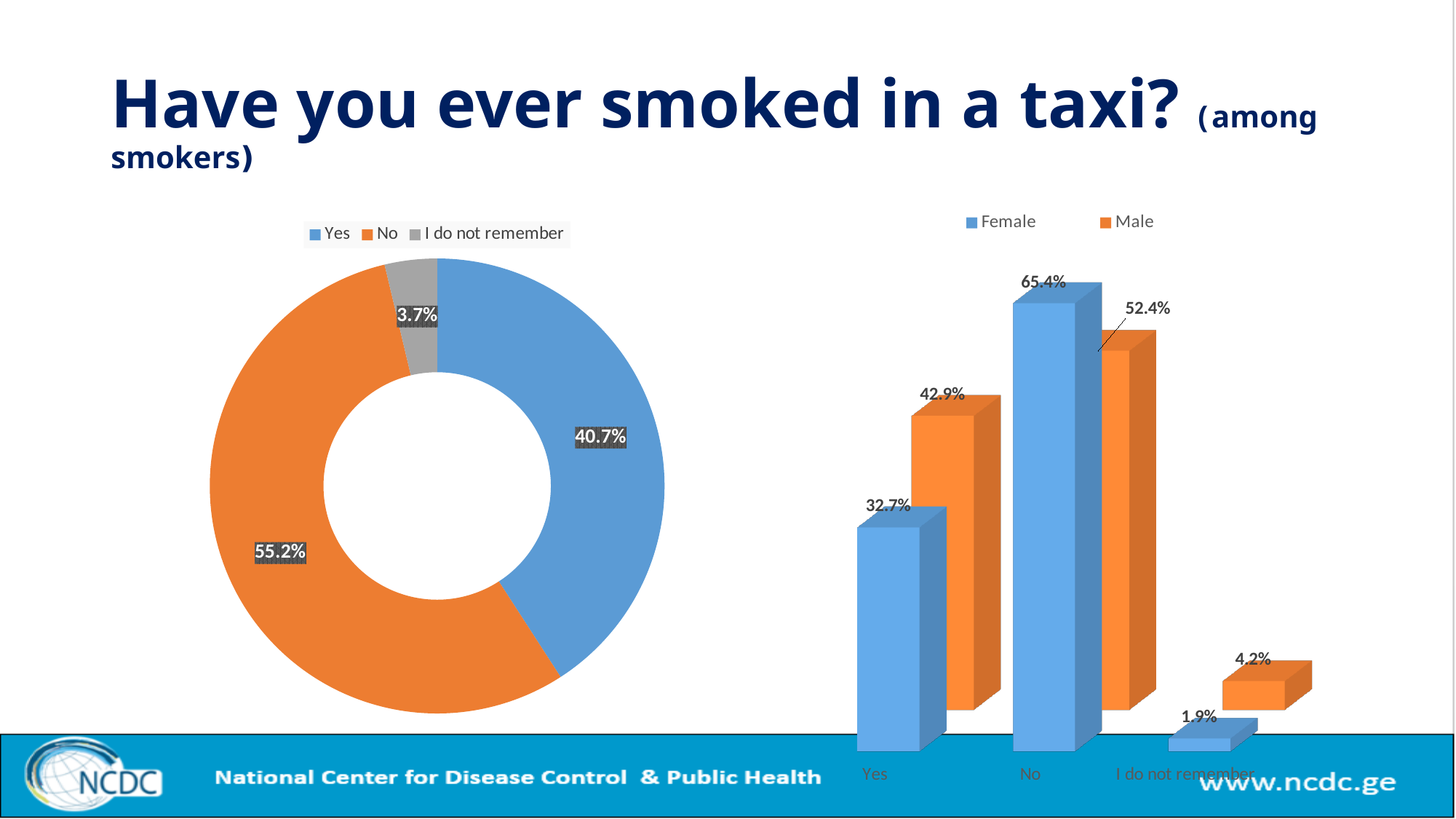
In the bar chart on the right, which is larger for "No": Female or Male? Female In the bar chart on the right, what is the difference between the Male and Female values for "Yes"? 10.2% In the doughnut chart on the left, how many categories does the legend list? 3 In the bar chart on the right, what is the Male value for "Yes"? 42.9% In the bar chart on the right, what is the Female value for "I do not remember"? 1.9% In the bar chart on the right, which category has the highest Male value? No In the doughnut chart on the left, which response has the smallest share? I do not remember In the doughnut chart on the left, what percentage answered "No"? 55.2% In the doughnut chart on the left, what percentage answered "Yes"? 40.7% What kind of chart is shown on the left of the slide? Doughnut chart In the bar chart on the right, how many series does the legend list? 2 In the bar chart on the right, what is the Female value for "No"? 65.4%